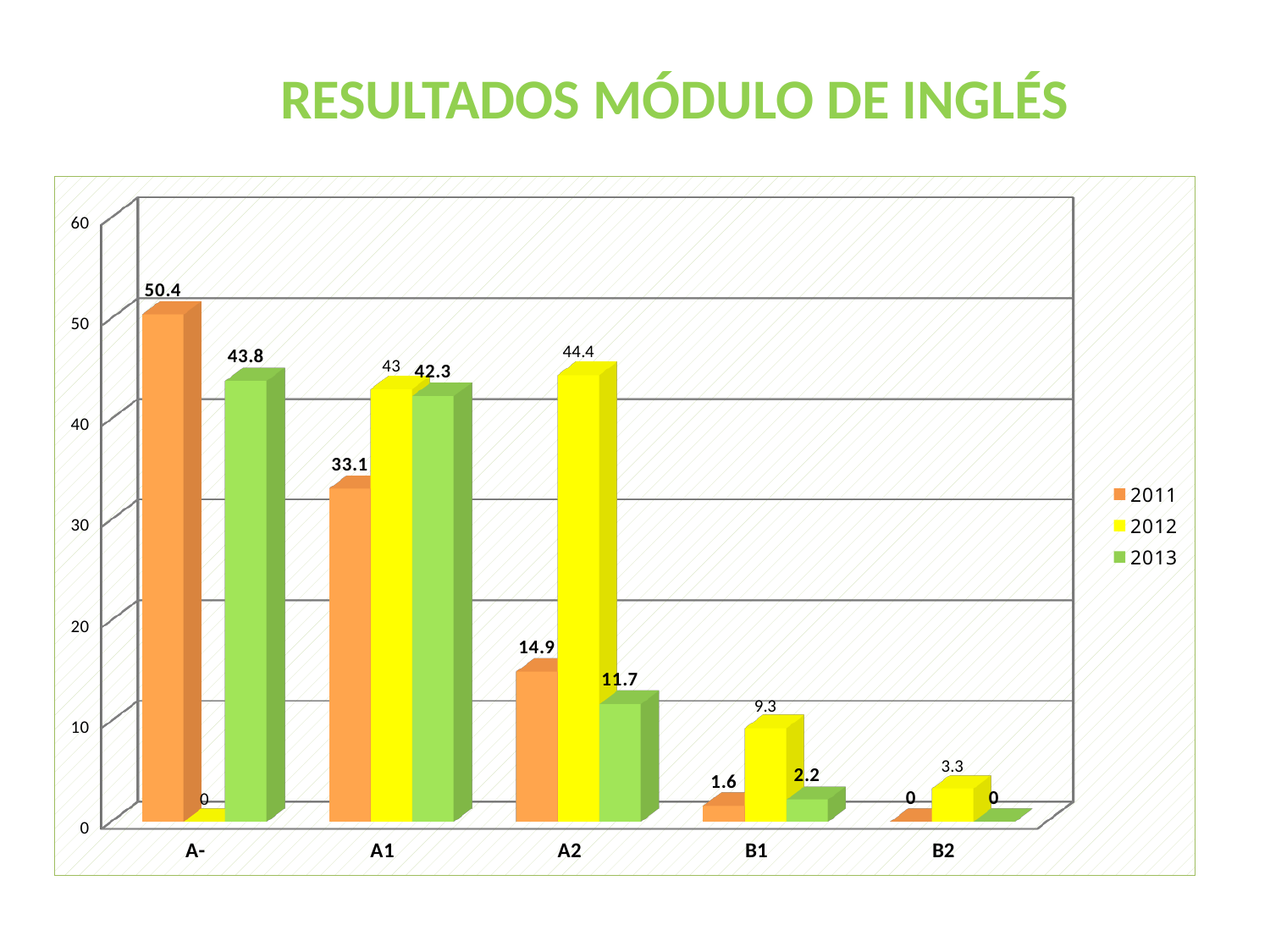
What is the difference between the 2011 and 2013 values for A-? 6.6 What is the value for A2 in the 2012 series? 44.4 What is the value for B1 in the 2013 series? 2.2 Which category has the lowest value in the 2012 series? A- Which category has the highest value in the 2011 series? A- How many categories are shown on the x axis? 5 Do the 2011 values rise or fall from A- to B2 along the x axis? Fall What is the title of the slide? RESULTADOS MÓDULO DE INGLÉS Which is larger for A1: the 2012 value or the 2013 value? 2012 What kind of chart is shown on the slide? Bar chart What is the value for A- in the 2011 series? 50.4 How many series does the legend list? 3